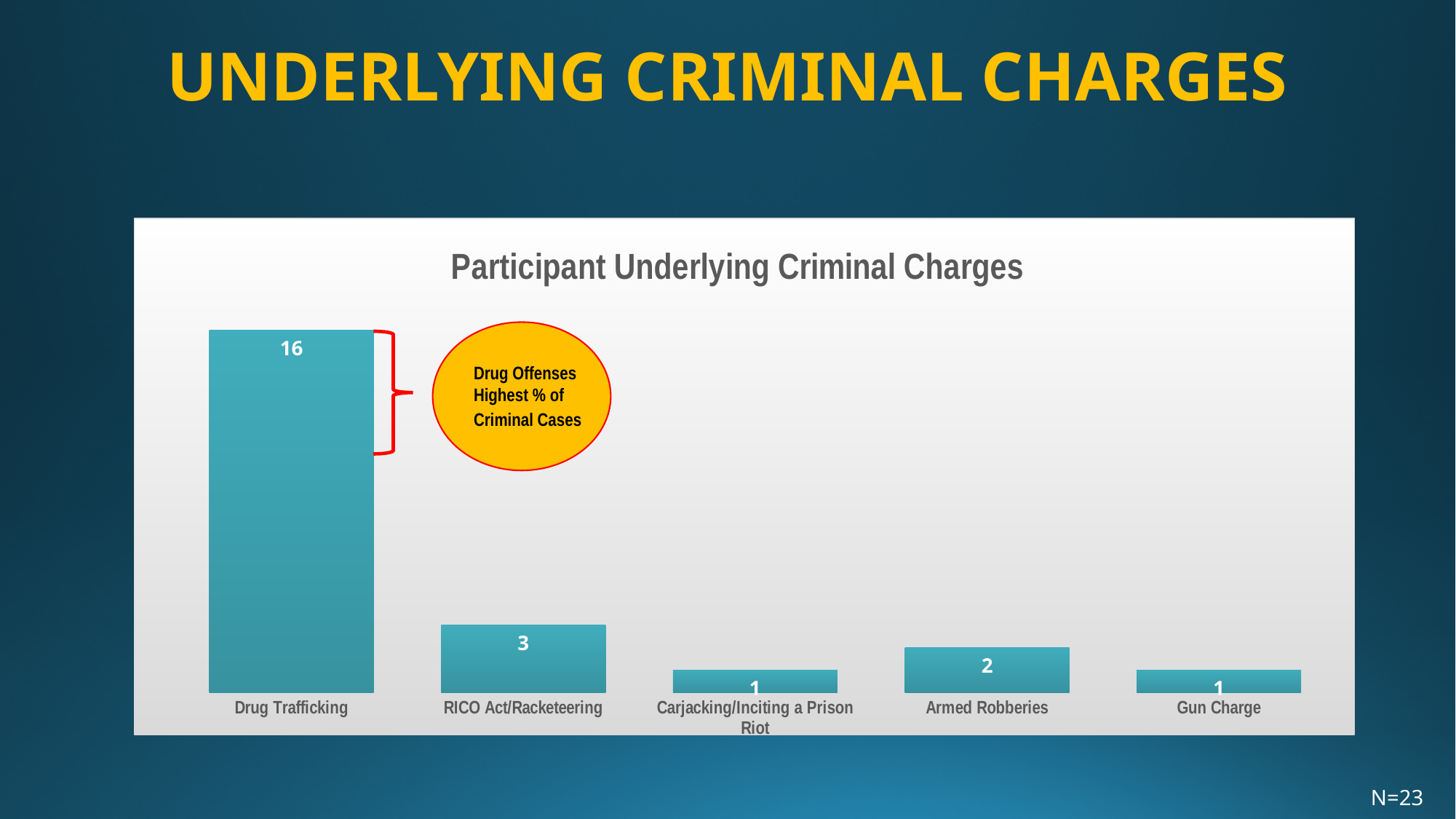
What kind of chart is shown on the slide? Bar chart What does the yellow callout next to the Drug Trafficking bar say? Drug Offenses Highest % of Criminal Cases Which is larger, the value for RICO Act/Racketeering or the value for Armed Robberies? RICO Act/Racketeering What is the value for Armed Robberies? 2 Which category has the highest value? Drug Trafficking How many categories are shown in the chart? 5 What is the value for Gun Charge? 1 What is the difference between the values for Armed Robberies and Gun Charge? 1 What is the title of the chart? Participant Underlying Criminal Charges What is the difference between the values for Drug Trafficking and RICO Act/Racketeering? 13 What is the value for RICO Act/Racketeering? 3 What is the value for Drug Trafficking? 16